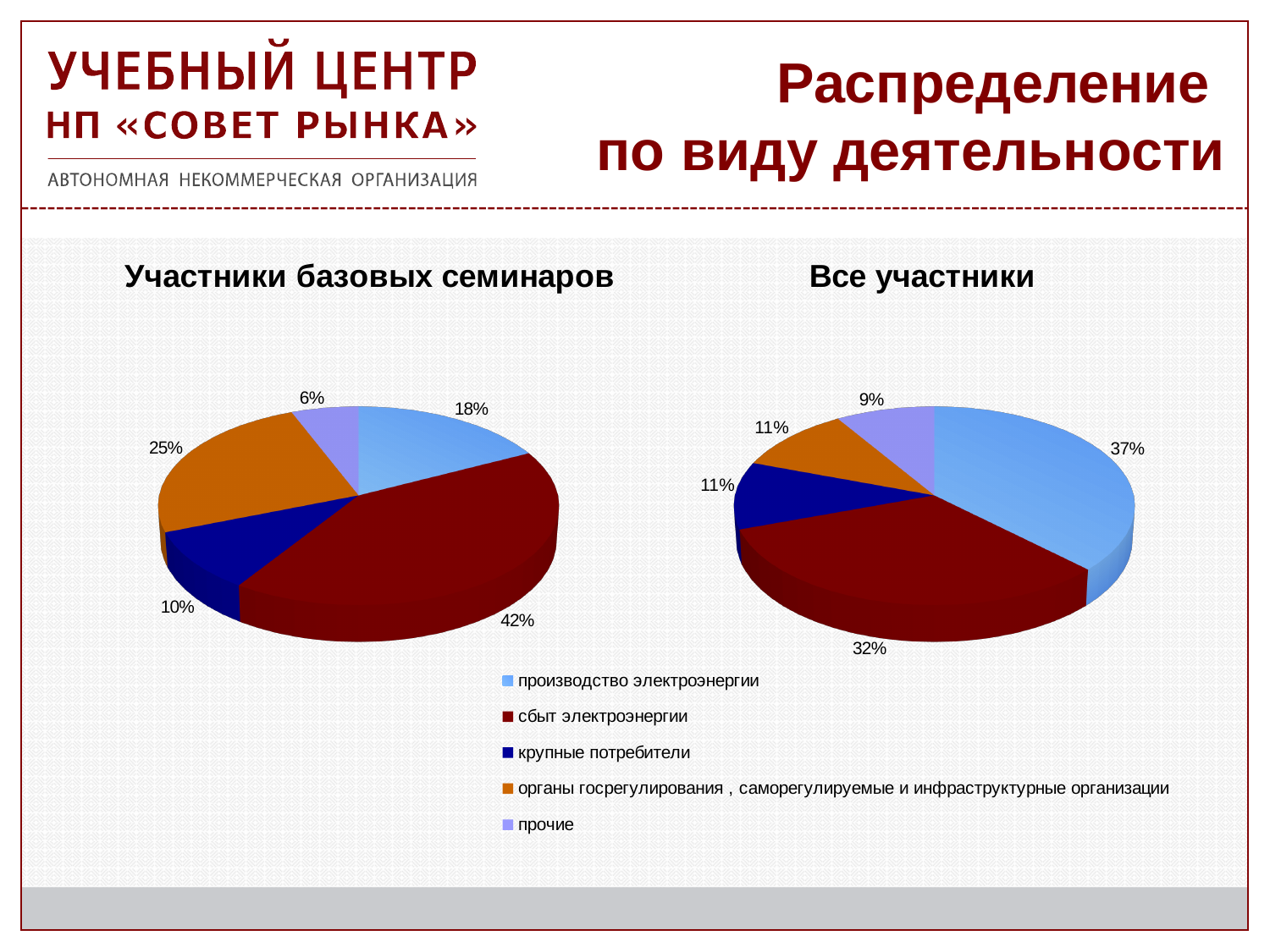
In the chart titled "Участники базовых семинаров", what share is labelled for сбыт электроэнергии? 42% In the chart titled "Участники базовых семинаров", what share is labelled for органы госрегулирования, саморегулируемые и инфраструктурные организации? 25% In the chart titled "Все участники", what share is labelled for прочие? 9% In the chart titled "Участники базовых семинаров", which category has the largest slice? сбыт электроэнергии In the chart titled "Все участники", which category has the smallest slice? прочие In the chart titled "Все участники", which category has the largest slice? производство электроэнергии In the chart titled "Участники базовых семинаров", which category has the smallest slice? прочие In the chart titled "Все участники", what share is labelled for производство электроэнергии? 37% How many categories does the shared legend list for the two pie charts? 5 In the chart titled "Все участники", which is larger: the share of производство электроэнергии or the share of сбыт электроэнергии? производство электроэнергии What type of chart is used for "Участники базовых семинаров"? Pie chart What is the difference between the share of производство электроэнергии in the "Все участники" chart and in the "Участники базовых семинаров" chart? 19 percentage points